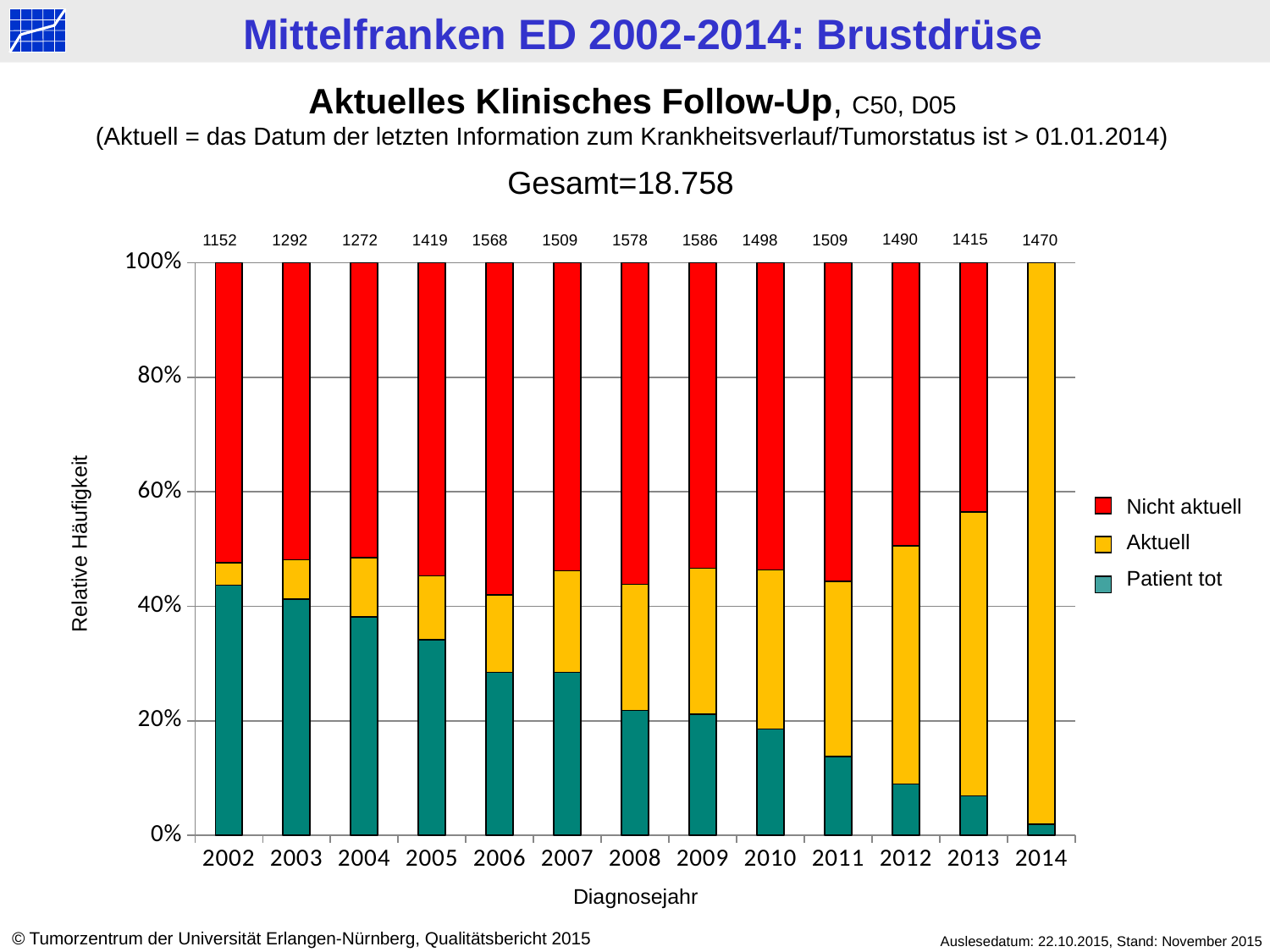
What kind of chart is shown on the slide? bar chart What is the label of the x axis? Diagnosejahr Is the 'Patient tot' share for 2013 greater or less than 20%? less How many series does the legend list? 3 Is the 'Patient tot' share for 2002 greater or less than 40%? greater What is the number printed above the bar for 2002? 1152 What is the number printed above the bar for 2009? 1586 Which year has the lowest number printed above its bar? 2002 Does the 'Patient tot' share rise or fall from 2002 to 2014? fall Which year has the highest number printed above its bar? 2009 How many diagnosis years are shown on the x axis? 13 What is the difference between the numbers printed above the bars for 2006 and 2005? 149